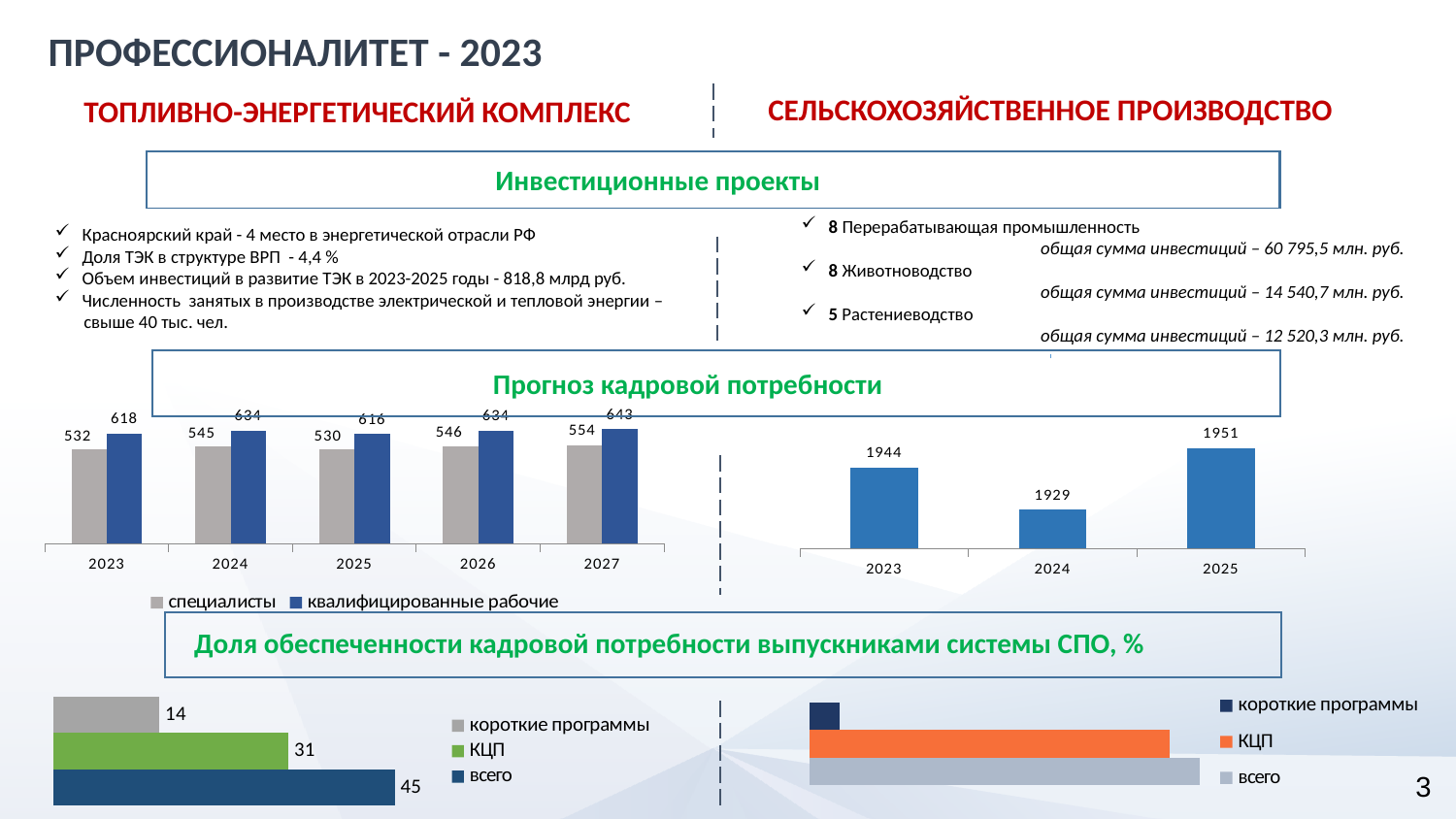
How many series does the legend of the left 'Прогноз кадровой потребности' chart list? 2 What kind of chart is the bottom-left 'Доля обеспеченности кадровой потребности' chart? bar chart In the bottom-left 'Доля обеспеченности кадровой потребности' chart, what is the value for КЦП? 31 In the left 'Прогноз кадровой потребности' chart, what is the value for квалифицированные рабочие in 2027? 643 In the right 'Прогноз кадровой потребности' chart, what is the value for 2024? 1929 In the right 'Прогноз кадровой потребности' chart, what is the difference between the 2025 and 2023 values? 7 In the right 'Прогноз кадровой потребности' chart, which year has the highest value? 2025 In the left 'Прогноз кадровой потребности' chart, what is the value for специалисты in 2023? 532 In the left 'Прогноз кадровой потребности' chart, which year has the highest value for квалифицированные рабочие? 2027 How many years are shown on the x axis of the left 'Прогноз кадровой потребности' chart? 5 In the left 'Прогноз кадровой потребности' chart, what is the difference between квалифицированные рабочие and специалисты in 2024? 89 In the left 'Прогноз кадровой потребности' chart, which year has the lowest value for специалисты? 2025